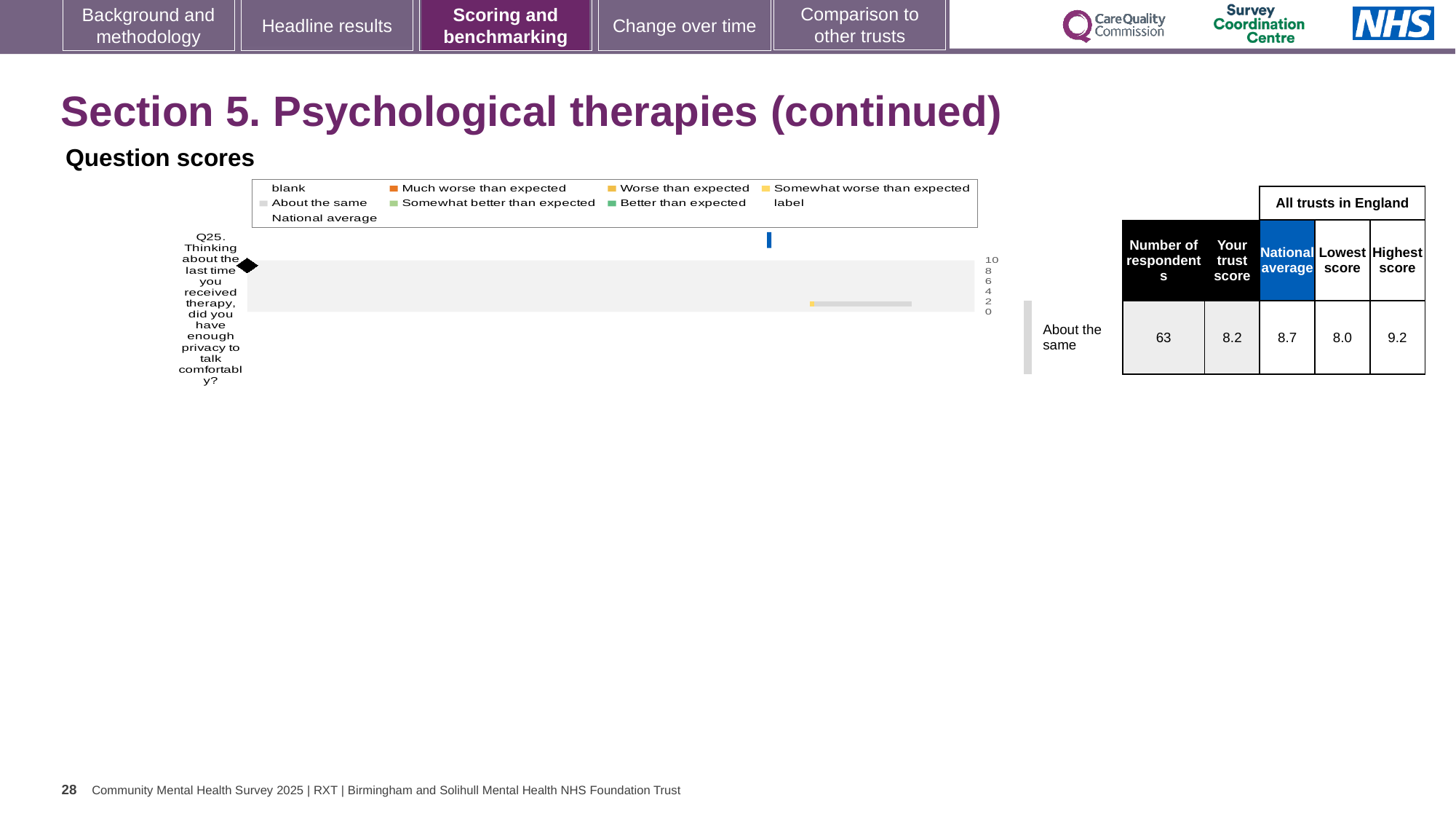
What kind of chart is shown under 'Question scores'? bar chart In the table beside the chart, how many respondents answered Q25? 63 In the table beside the chart, what is the national average for Q25? 8.7 What is the highest tick value shown on the axis of the Question scores chart? 10 How many questions are plotted in the Question scores chart? 1 In the table beside the chart, what is the highest score among all trusts in England for Q25? 9.2 In the table beside the chart, what is the trust score for Q25? 8.2 In the table beside the chart, what is the lowest score among all trusts in England for Q25? 8.0 What is the difference between the national average and the trust score for Q25? 0.5 What benchmark category is shown next to the chart for Q25? About the same Which question is plotted in the Question scores chart? Q25. Thinking about the last time you received therapy, did you have enough privacy to talk comfortably? Which is larger for Q25, the trust score or the national average? national average